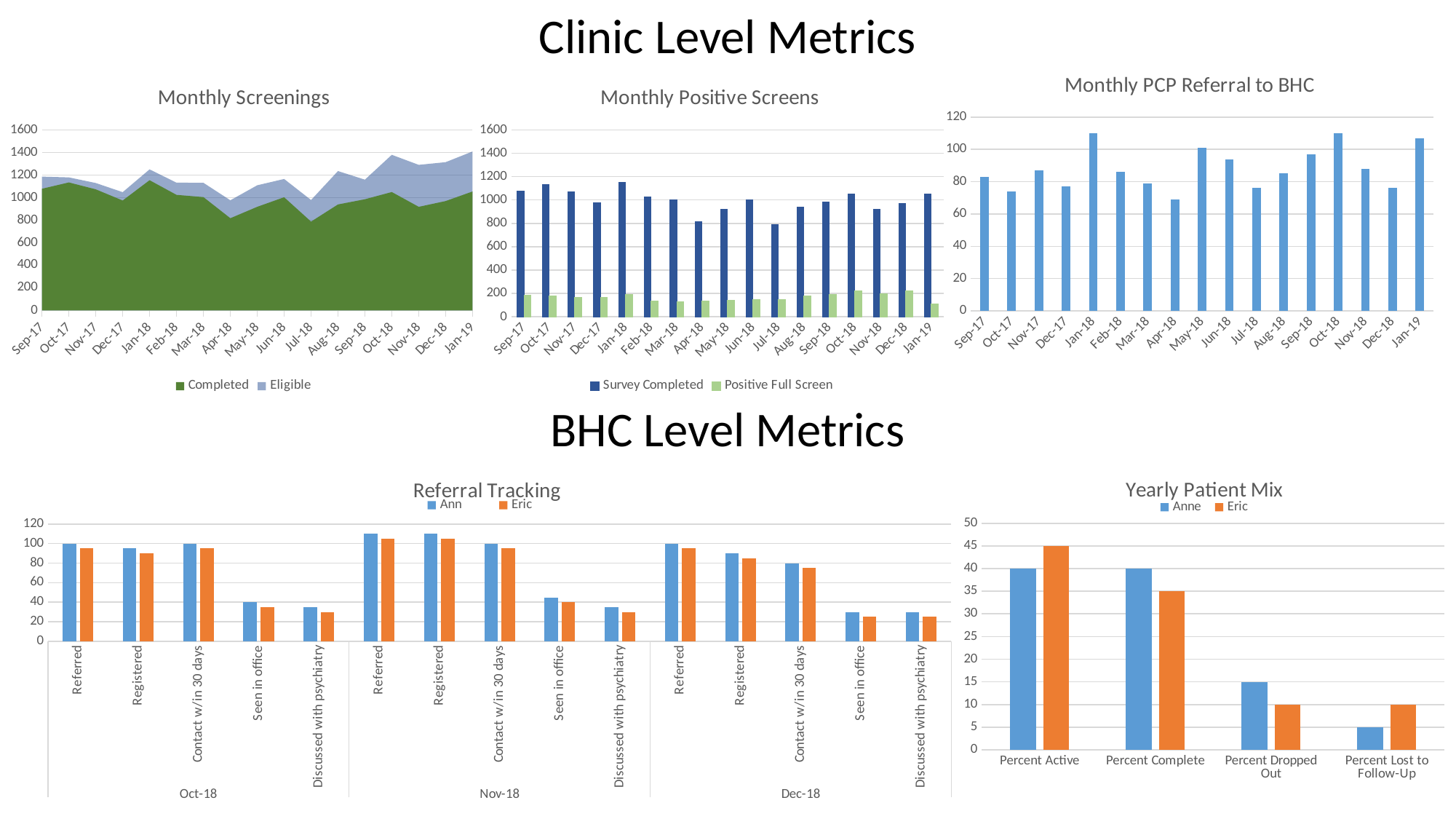
In the Referral Tracking chart, what is Ann's value for Referred in Oct-18? 100 In the Yearly Patient Mix chart, who has the larger value for Percent Lost to Follow-Up, Anne or Eric? Eric In the Monthly Positive Screens chart, is the Survey Completed value for Jan-18 greater or less than 1000? greater In the Yearly Patient Mix chart, what is Anne's value for Percent Dropped Out? 15 In the Monthly PCP Referral to BHC chart, is the value for Apr-18 greater or less than 80? less In the Monthly PCP Referral to BHC chart, is the value for Jan-18 greater or less than 100? greater In the Yearly Patient Mix chart, what is Eric's value for Percent Active? 45 How many months are plotted on the Monthly PCP Referral to BHC chart? 17 What kind of chart is the Monthly Screenings chart? Area chart In the Yearly Patient Mix chart, what is the difference between Eric's and Anne's Percent Active values? 5 What are the two legend entries of the Monthly Screenings chart? Completed and Eligible How many series does the legend of the Monthly Positive Screens chart list? 2